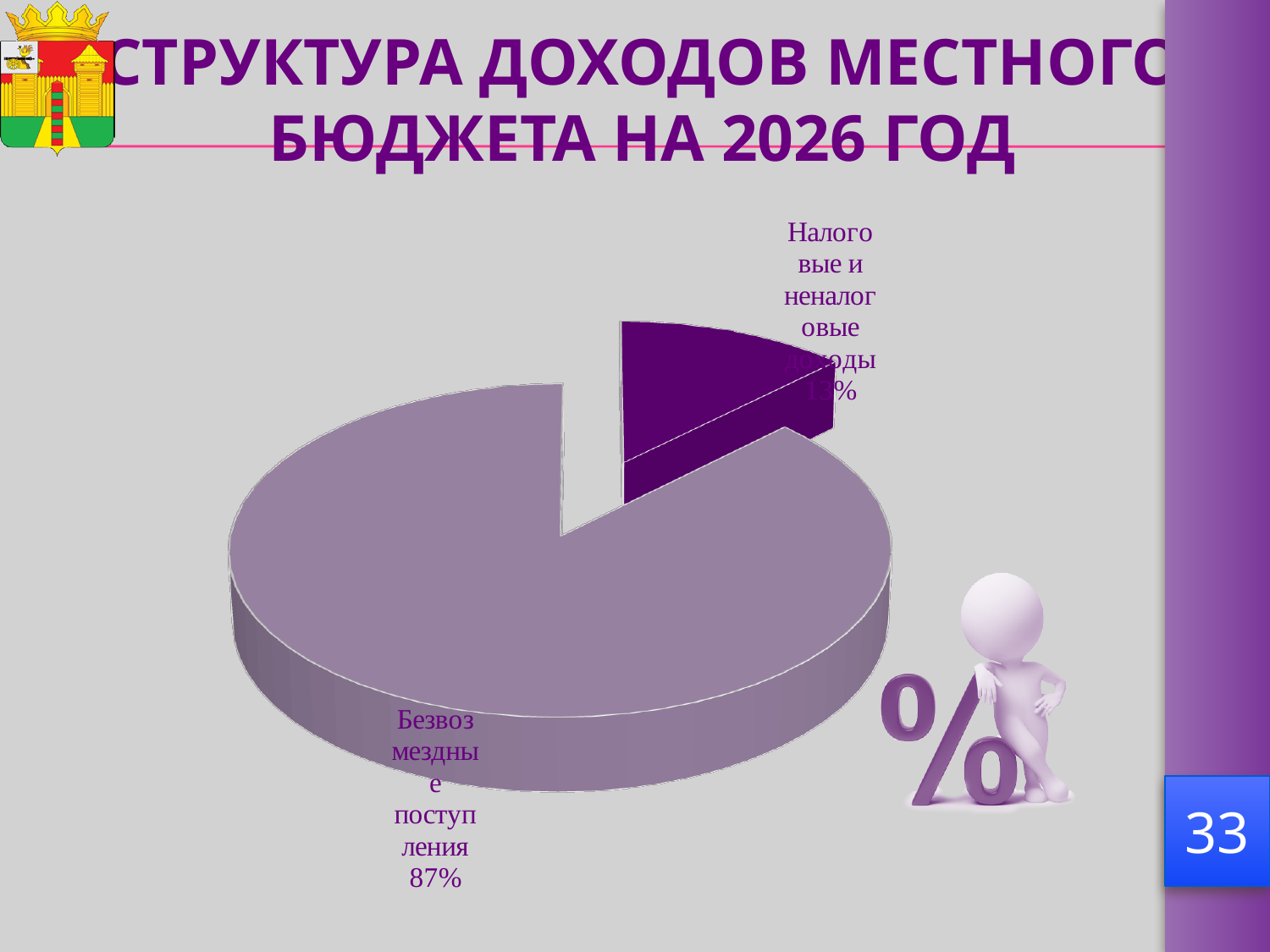
Which year does the chart's title refer to? 2026 What share of the pie does "Безвозмездные поступления" have? 87% Is the share of "Безвозмездные поступления" greater or less than 50%? greater Which slice of the pie chart is the largest? Безвозмездные поступления Which slice of the pie chart is the smallest? Налоговые и неналоговые доходы What kind of chart is shown on the slide? Pie chart How many slices does the pie chart have? 2 Which is larger: the share of "Безвозмездные поступления" or the share of "Налоговые и неналоговые доходы"? Безвозмездные поступления What is the difference in percentage points between "Безвозмездные поступления" and "Налоговые и неналоговые доходы"? 74 percentage points What share of the pie does "Налоговые и неналоговые доходы" have? 13% What is the title of the slide containing the pie chart? СТРУКТУРА ДОХОДОВ МЕСТНОГО БЮДЖЕТА НА 2026 ГОД